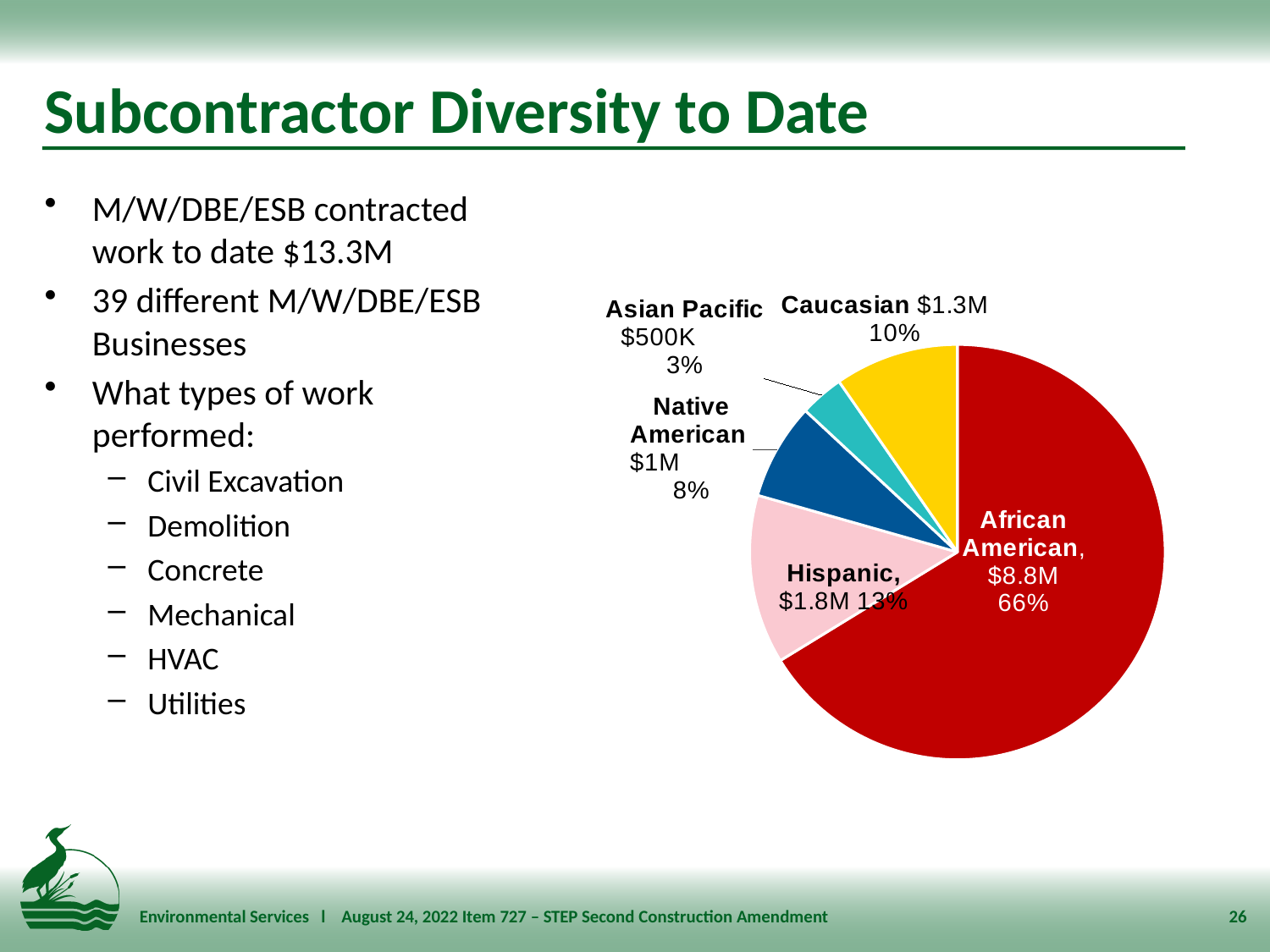
What is the dollar value shown for African American in the pie chart? $8.8M Which is larger, the Hispanic slice or the Caucasian slice? Hispanic Which category has the smallest slice of the pie? Asian Pacific What is the dollar value shown for Caucasian? $1.3M How many slices does the pie chart have? 5 What is the dollar value shown for Native American? $1M What type of chart is shown on the slide? pie chart Which category has the largest slice of the pie? African American What colour is the African American slice? red What is the difference in percentage points between the African American share and the Hispanic share? 53% What percentage share does the Hispanic slice have? 13% What percentage share does the Asian Pacific slice have? 3%